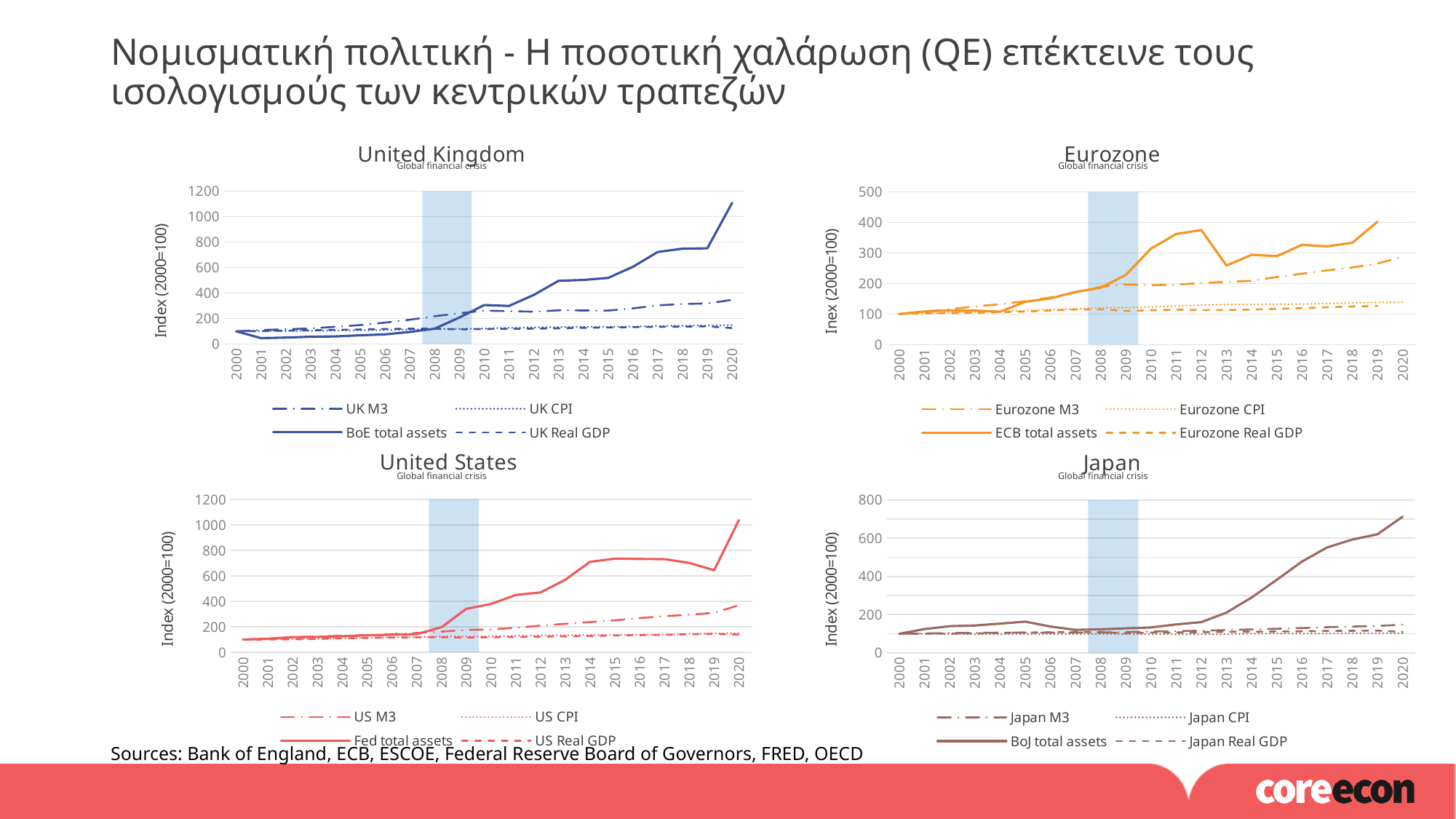
In the Japan chart, is the value for BoJ total assets in 2020 greater or less than 600? greater In the Eurozone chart, is the value for ECB total assets in 2019 greater or less than 300? greater In the Eurozone chart, which series has the highest value in 2019? ECB total assets In the United States chart, is the value for Fed total assets in 2020 greater or less than 800? greater What kind of chart is the United Kingdom chart? line chart In the United Kingdom chart, which is higher in 2020, BoE total assets or UK M3? BoE total assets What is the y-axis label of the United States chart? Index (2000=100) What event does the shaded band on each chart mark? Global financial crisis How many series does the legend of the United Kingdom chart list? 4 In the Japan chart, do the values for BoJ total assets rise or fall from 2012 to 2020? rise